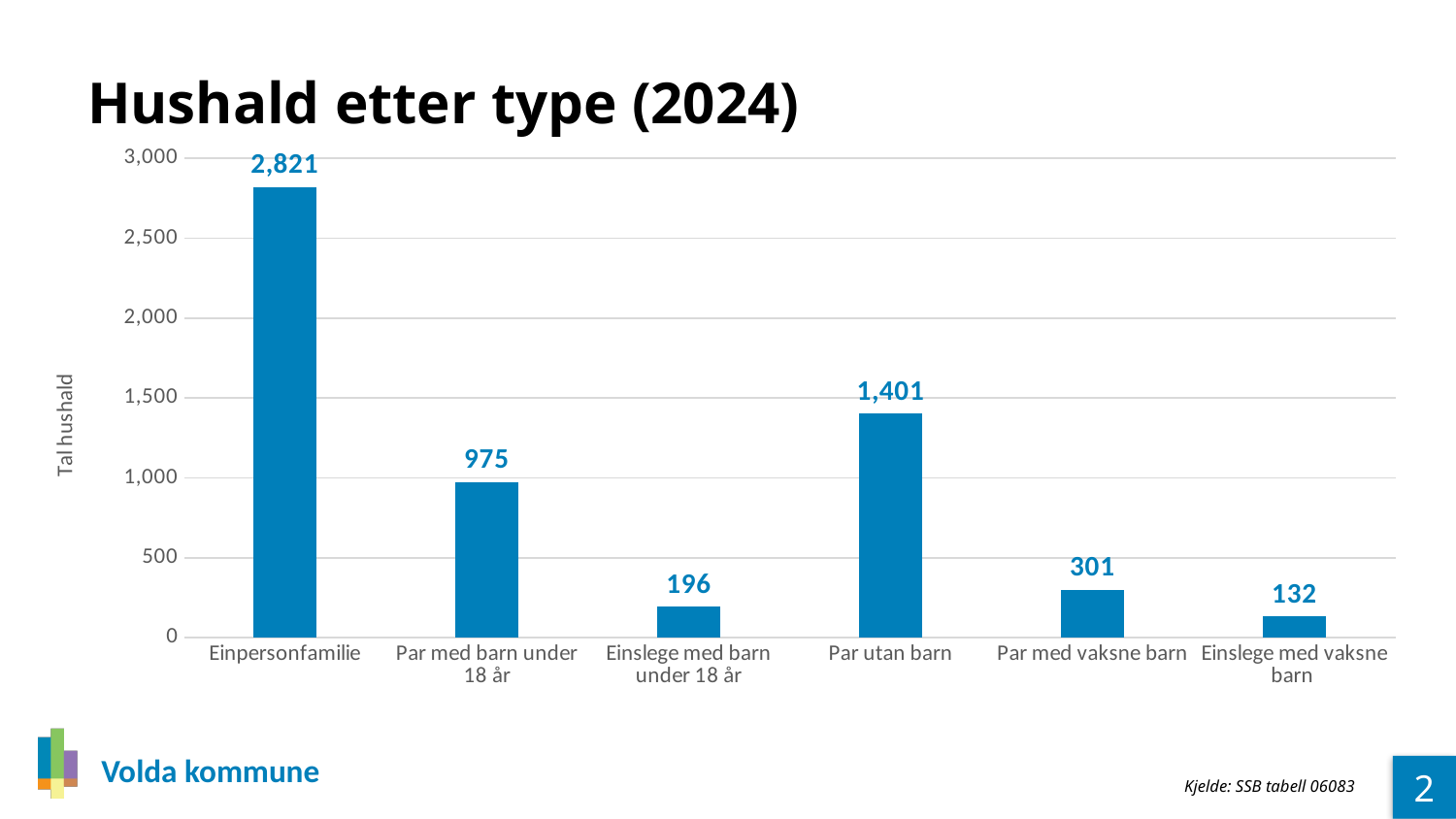
What kind of chart is shown on the slide? bar chart What is the difference between Par med vaksne barn and Einslege med vaksne barn? 169 What is the difference between Einpersonfamilie and Par utan barn? 1,420 What is the value for Par utan barn? 1,401 How many categories are shown on the x axis? 6 What is the title of the chart? Hushald etter type (2024) What is the value for Einpersonfamilie? 2,821 Which category has the highest value? Einpersonfamilie Which is larger, Par med barn under 18 år or Par utan barn? Par utan barn Which category has the lowest value? Einslege med vaksne barn What is the value for Einslege med barn under 18 år? 196 Is the value for Par med barn under 18 år greater or less than 1,000? less